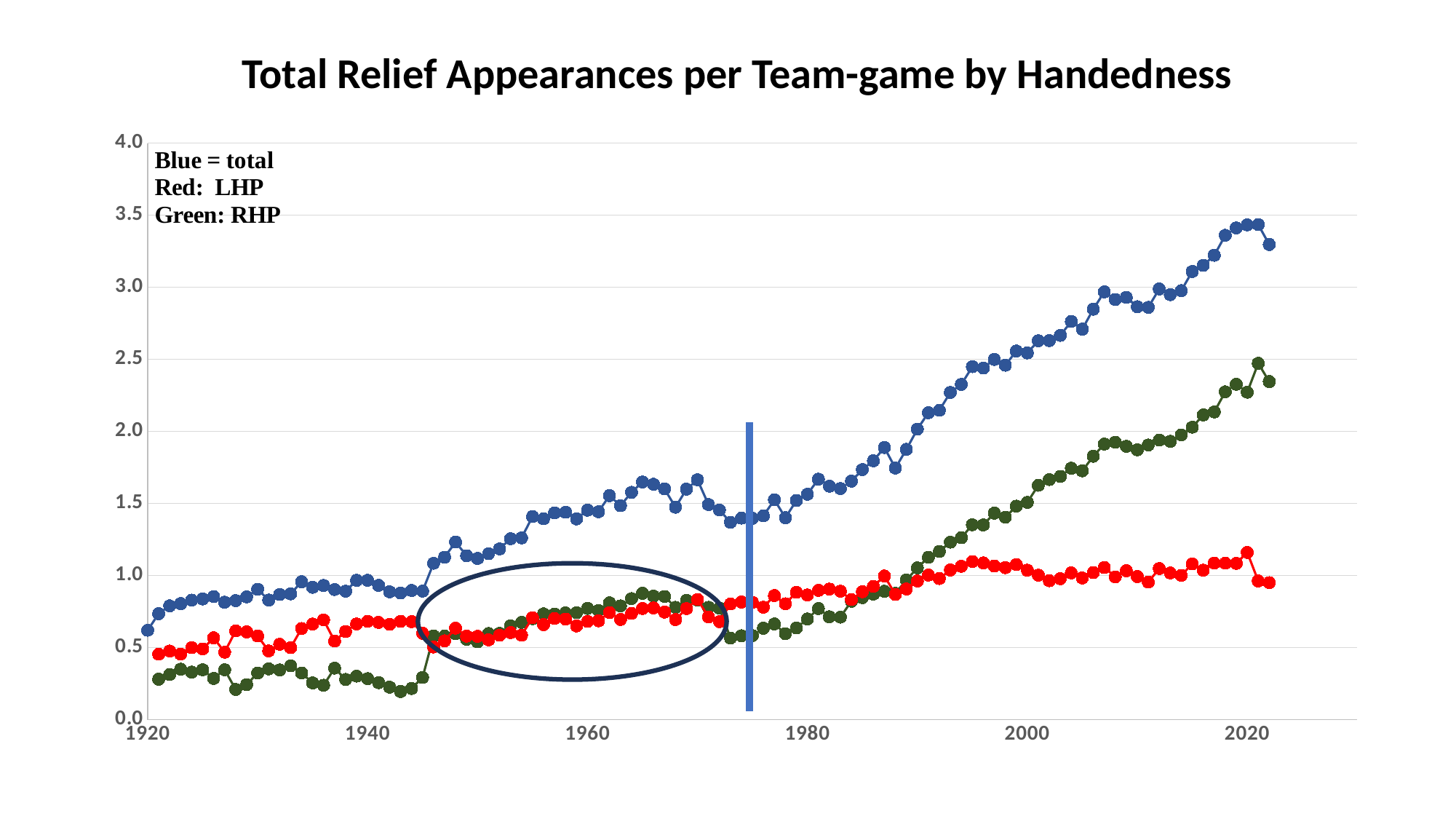
Does the blue (total) series generally rise or fall from 1920 to 2020? rise Is the value of the green (RHP) series in 2020 greater or less than 2.0? greater How many series are plotted on the chart? 3 What is the title of the chart? Total Relief Appearances per Team-game by Handedness Is the value of the blue (total) series in 2020 greater or less than 3.0? greater Is the value of the red (LHP) series in 2020 greater or less than 1.5? less According to the legend text, which series does the red line represent? LHP In 2000, which series has the larger value, green (RHP) or red (LHP)? green (RHP) What kind of chart is shown on the slide? line chart